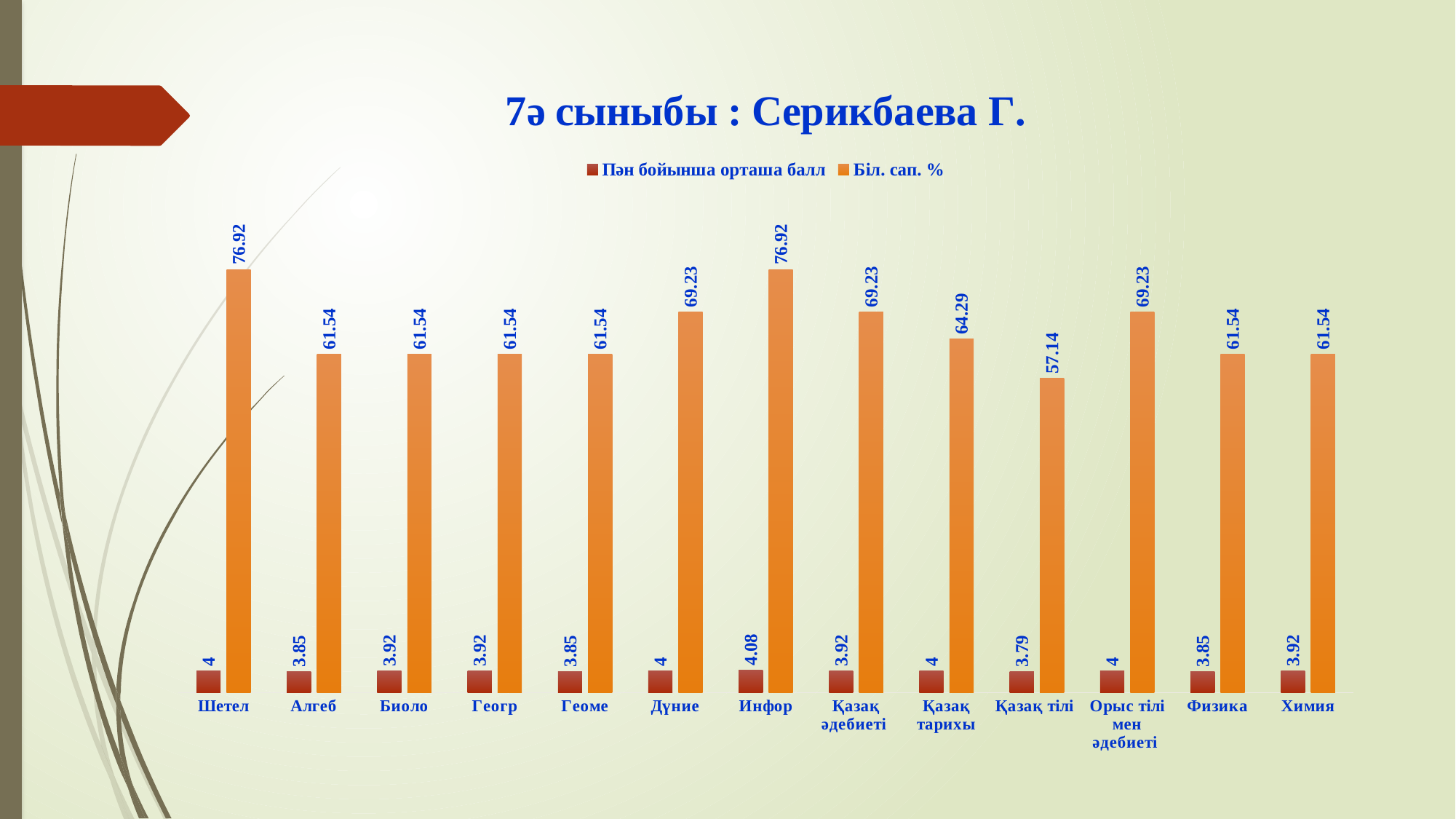
Which subject has the lowest "Пән бойынша орташа балл" value? Қазақ тілі What is the value of "Біл. сап. %" for Қазақ тарихы? 64.29 What is the value of "Біл. сап. %" for Шетел? 76.92 Which subject has the highest "Пән бойынша орташа балл" value? Инфор What type of chart is shown on the slide? bar chart Which subject has the lowest "Біл. сап. %" value? Қазақ тілі How many subjects (categories) are shown on the x axis? 13 How many series does the legend list? 2 What is the title of the chart? 7ә сыныбы : Серикбаева Г. What is the value of "Пән бойынша орташа балл" for Инфор? 4.08 What is the difference between the "Біл. сап. %" values for Шетел and Алгеб? 15.38 Which has a larger "Біл. сап. %" value, Дүние or Физика? Дүние